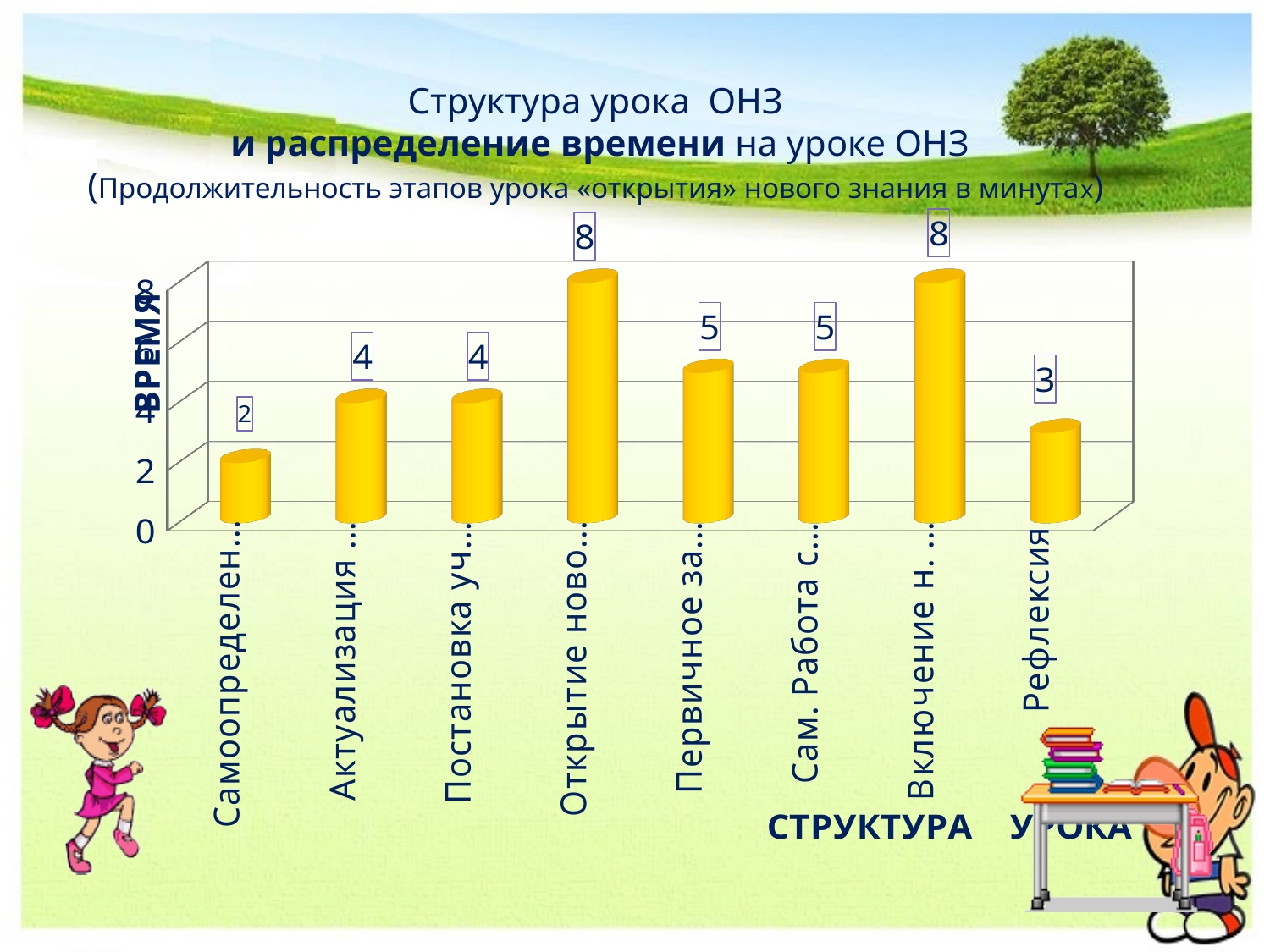
How many categories (lesson stages) are plotted in the chart? 8 What is the highest value shown in the chart? 8 What is the value for the category whose label begins with "Самоопределен"? 2 Which category has the lowest value in the chart? Самоопределен... What is the difference between the value for the category beginning with "Открытие ново" and the value for "Рефлексия"? 5 What label is written along the vertical axis of the chart? ВРЕМЯ Which is larger: the value for the category beginning with "Первичное за" or the value for the category beginning with "Постановка уч"? Первичное за... What is the value for the category whose label begins with "Первичное за"? 5 What type of chart is shown on the slide? bar chart What is the value for the category whose label begins with "Актуализация"? 4 Is the value for "Рефлексия" greater or less than 4? less What is the value for the category "Рефлексия"? 3